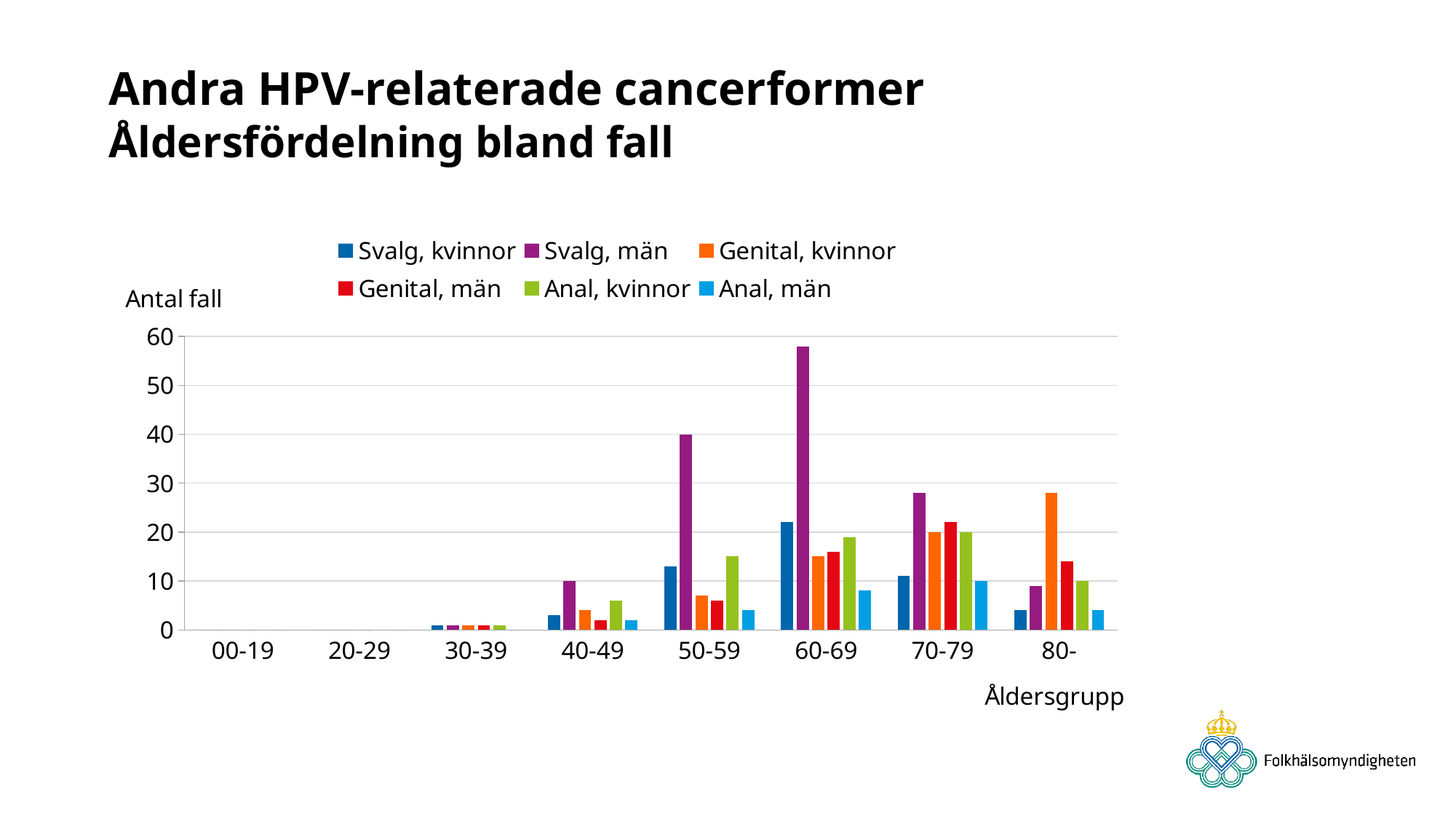
Is the value for Anal, kvinnor in the 60-69 age group greater or less than 10? greater Is the value for Svalg, män in the 60-69 age group greater or less than 50? greater How many age groups are shown on the x axis? 8 In which age group is the bar for Svalg, män the highest? 60-69 In the 50-59 age group, which is larger: Svalg, män or Anal, kvinnor? Svalg, män In the 80- age group, which is larger: Genital, kvinnor or Svalg, män? Genital, kvinnor How many series does the legend list? 6 What is the title of the y axis? Antal fall Is the value for Genital, kvinnor in the 80- age group greater or less than 20? greater What kind of chart is shown on the slide? Bar chart Which series has the tallest bar in the whole chart? Svalg, män